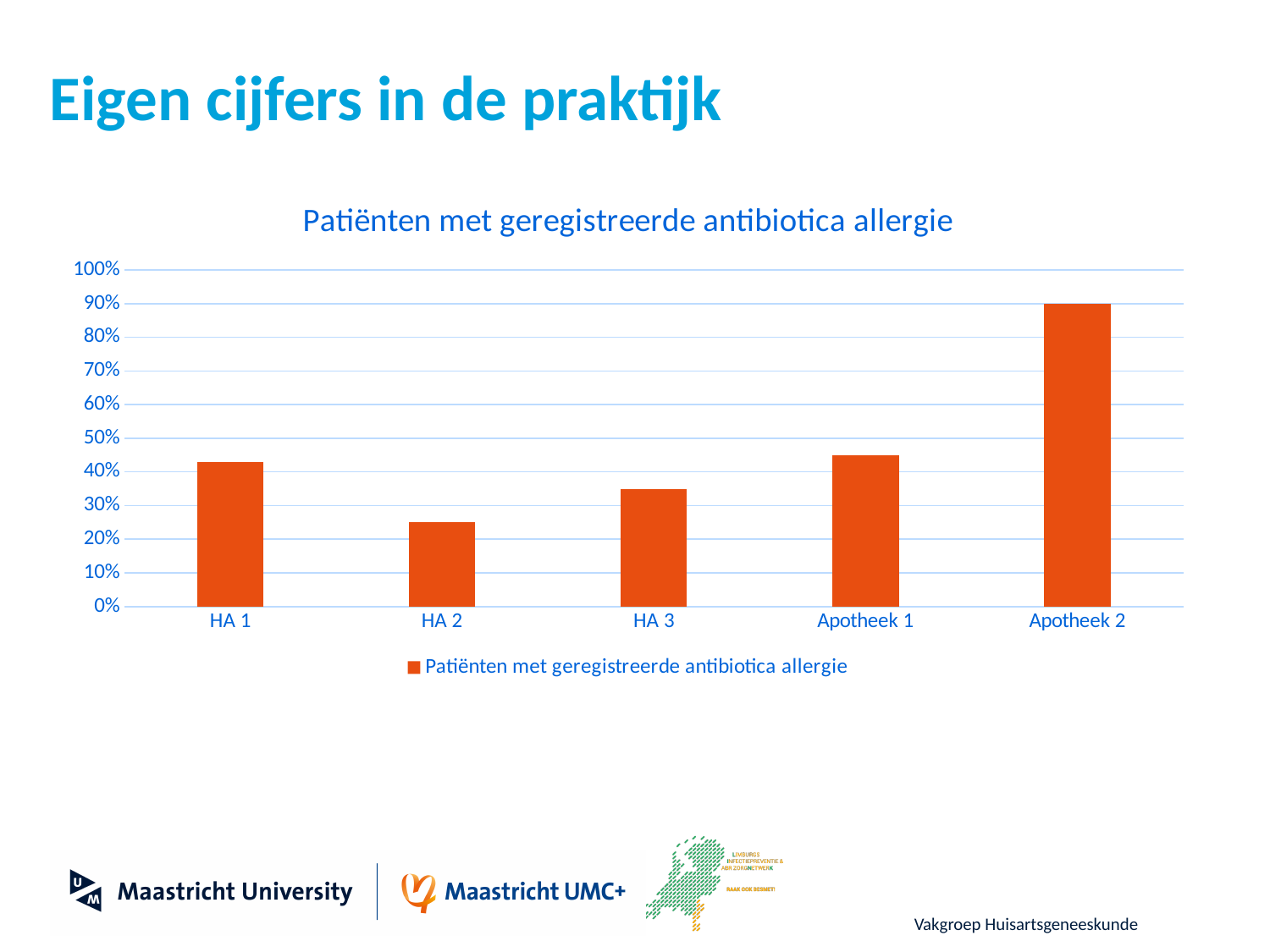
Is the value for HA 1 greater or less than 40%? greater Which category has the highest value in the chart? Apotheek 2 Is the value for Apotheek 1 greater or less than 50%? less Is the value for HA 2 greater or less than 30%? less How many categories are shown on the x axis of the chart? 5 Which is larger, the value for HA 1 or the value for HA 3? HA 1 What is the value for Apotheek 2? 90% Which category has the lowest value in the chart? HA 2 How many series does the chart legend list? 1 What kind of chart is shown on the slide? bar chart What is the title of the chart? Patiënten met geregistreerde antibiotica allergie